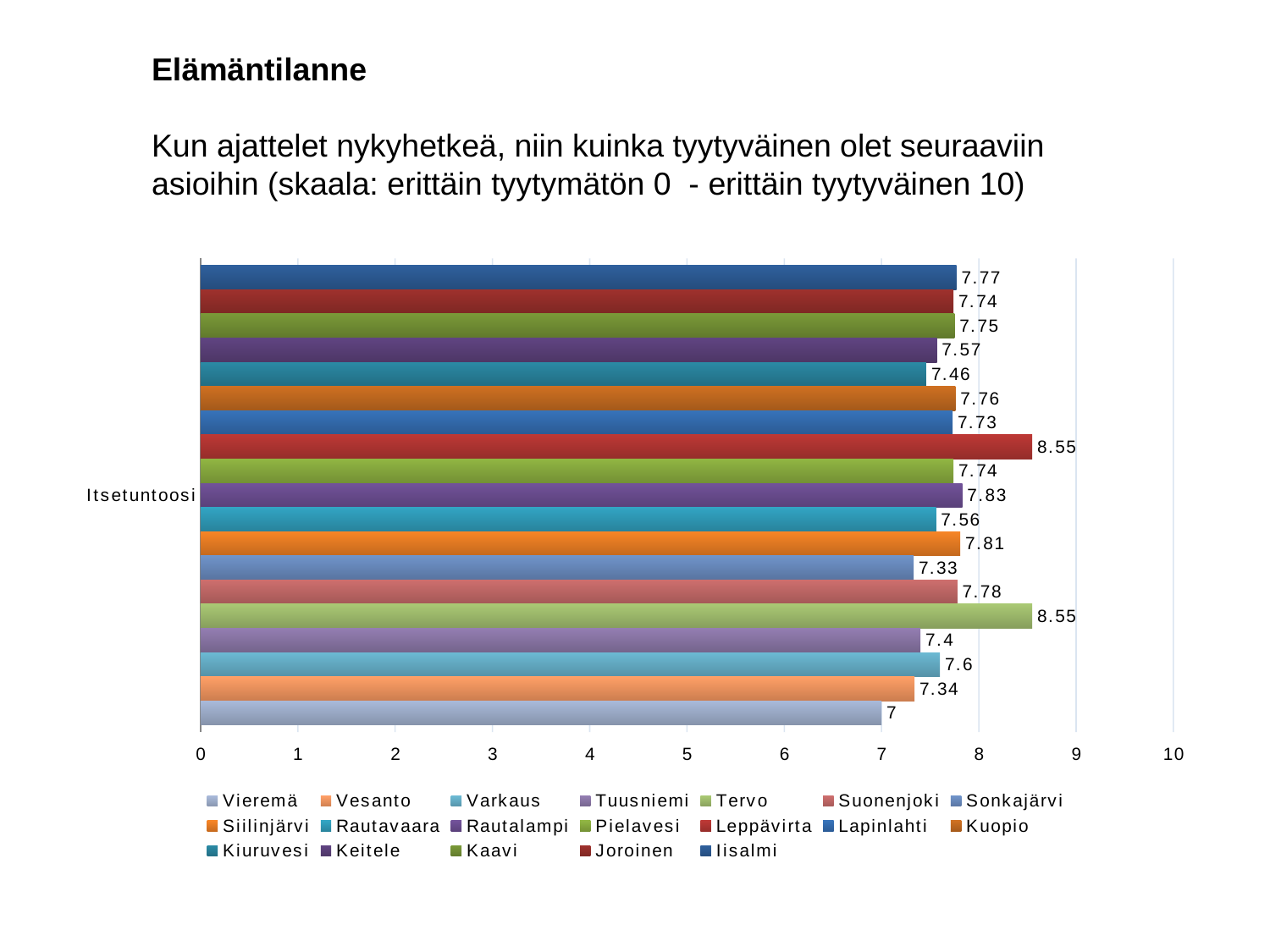
Which two municipalities share the highest value of 8.55? Tervo and Leppävirta What is the difference between the values for Tervo and Vieremä? 1.55 What is the value for Iisalmi? 7.77 What is the category label shown on the vertical axis? Itsetuntoosi Which is larger, the value for Rautalampi or the value for Kiuruvesi? Rautalampi What is the value for Vieremä? 7 What is the value for Sonkajärvi? 7.33 How many series does the legend list? 19 What is the value for Leppävirta? 8.55 Is the value for Vesanto greater or less than 8? less What kind of chart is shown on the slide? bar chart Which municipality has the lowest value? Vieremä